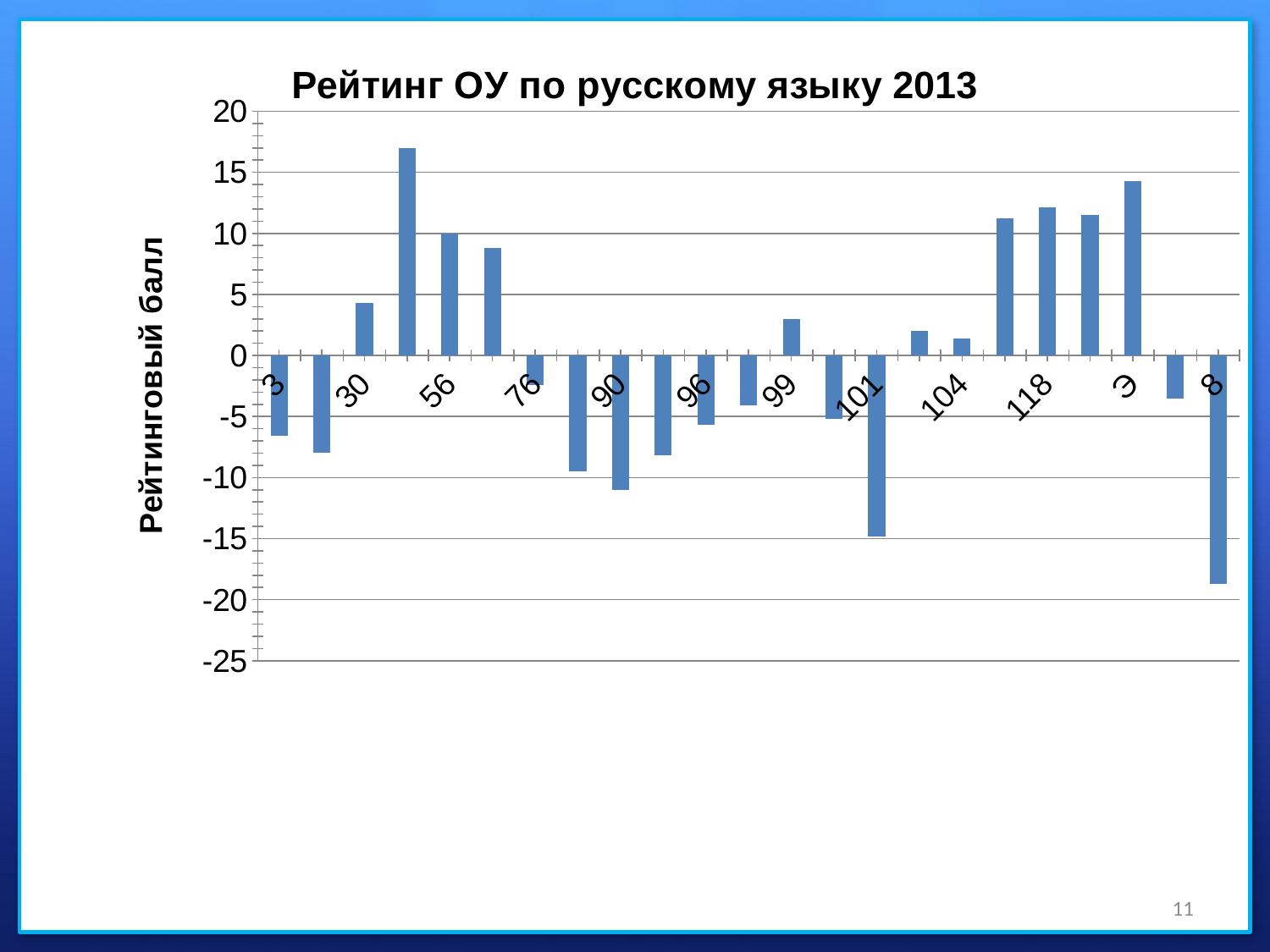
What type of chart is shown on the slide? bar chart Is the value for category 104 greater or less than 5? less Which has the larger value, category 101 or category 99? 99 What is the title of the chart? Рейтинг ОУ по русскому языку 2013 Is the value for category 3 greater or less than -5? less Is the value for category 76 greater or less than -5? greater Which labelled category has the lowest value? 8 Which has the larger value, category 118 or category 104? 118 What is the label of the vertical axis? Рейтинговый балл